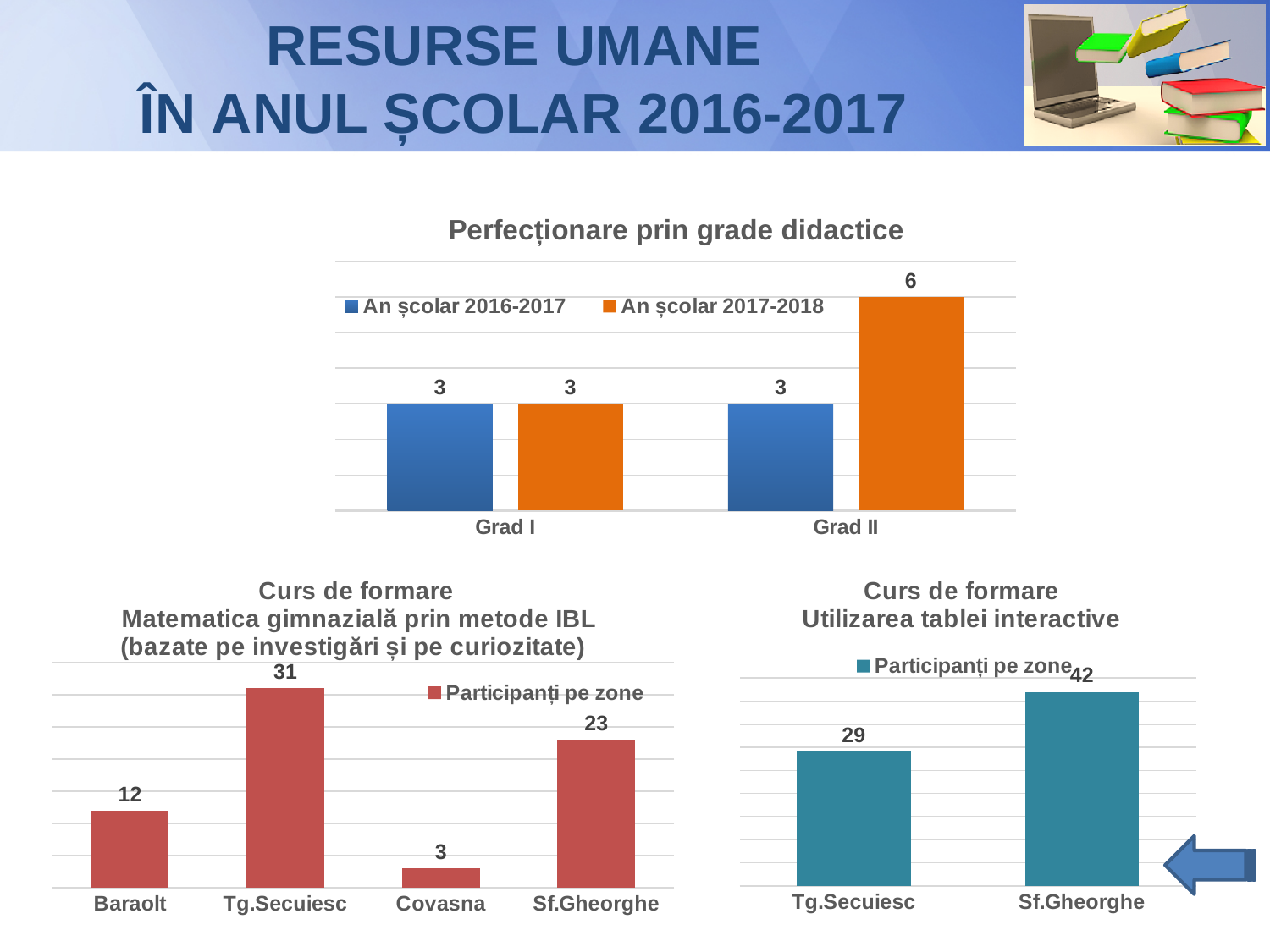
In the 'Curs de formare Matematica gimnazială prin metode IBL' chart, what is the difference between Tg.Secuiesc and Sf.Gheorghe? 8 What kind of chart is the 'Curs de formare Utilizarea tablei interactive' chart? Bar chart In the 'Curs de formare Matematica gimnazială prin metode IBL' chart, which zone has the highest number of participants? Tg.Secuiesc In the 'Perfecționare prin grade didactice' chart, what is the difference between the An școlar 2017-2018 and An școlar 2016-2017 values for Grad II? 3 In the 'Perfecționare prin grade didactice' chart, what is the value for Grad I in An școlar 2016-2017? 3 In the 'Curs de formare Matematica gimnazială prin metode IBL' chart, what is the value for Baraolt? 12 In the 'Curs de formare Utilizarea tablei interactive' chart, which is larger, Tg.Secuiesc or Sf.Gheorghe? Sf.Gheorghe In the 'Perfecționare prin grade didactice' chart, how many series does the legend list? 2 In the 'Curs de formare Matematica gimnazială prin metode IBL' chart, which zone has the lowest number of participants? Covasna In the 'Curs de formare Matematica gimnazială prin metode IBL' chart, how many zones are shown on the x axis? 4 In the 'Curs de formare Utilizarea tablei interactive' chart, what is the value for Sf.Gheorghe? 42 In the 'Perfecționare prin grade didactice' chart, what is the value for Grad II in An școlar 2017-2018? 6